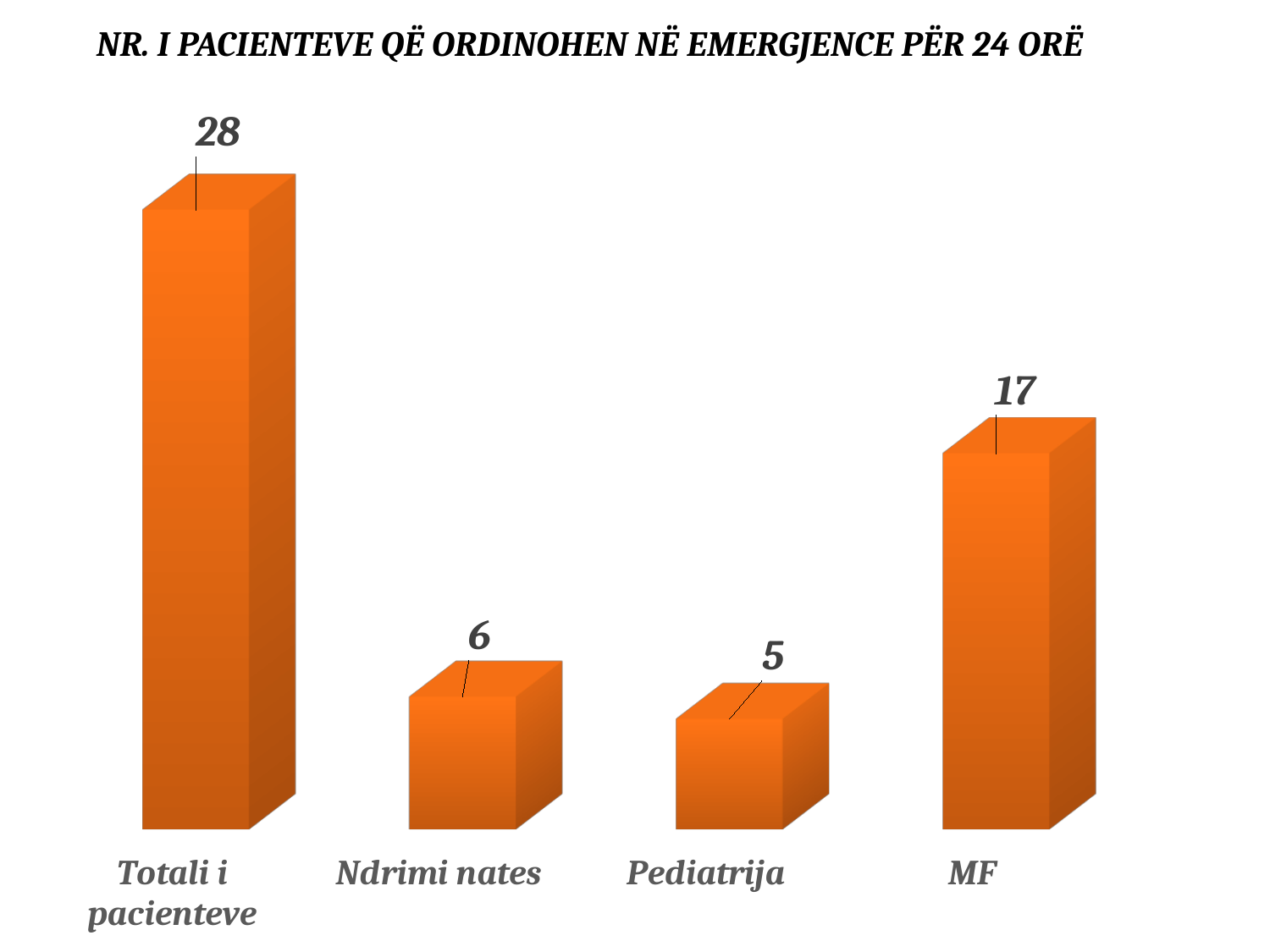
What is the value for Ndrimi nates? 6 Which category has the highest value? Totali i pacienteve What kind of chart is shown on the slide? Bar chart What is the difference between the values for Totali i pacienteve and MF? 11 What is the value for MF? 17 How many categories are shown in the chart? 4 What is the value for Totali i pacienteve? 28 Which category has the lowest value? Pediatrija Which is larger, the value for MF or the value for Ndrimi nates? MF What is the value for Pediatrija? 5 What is the title of the chart? NR. I PACIENTEVE QË ORDINOHEN NË EMERGJENCE PËR 24 ORË What is the difference between the values for Ndrimi nates and Pediatrija? 1